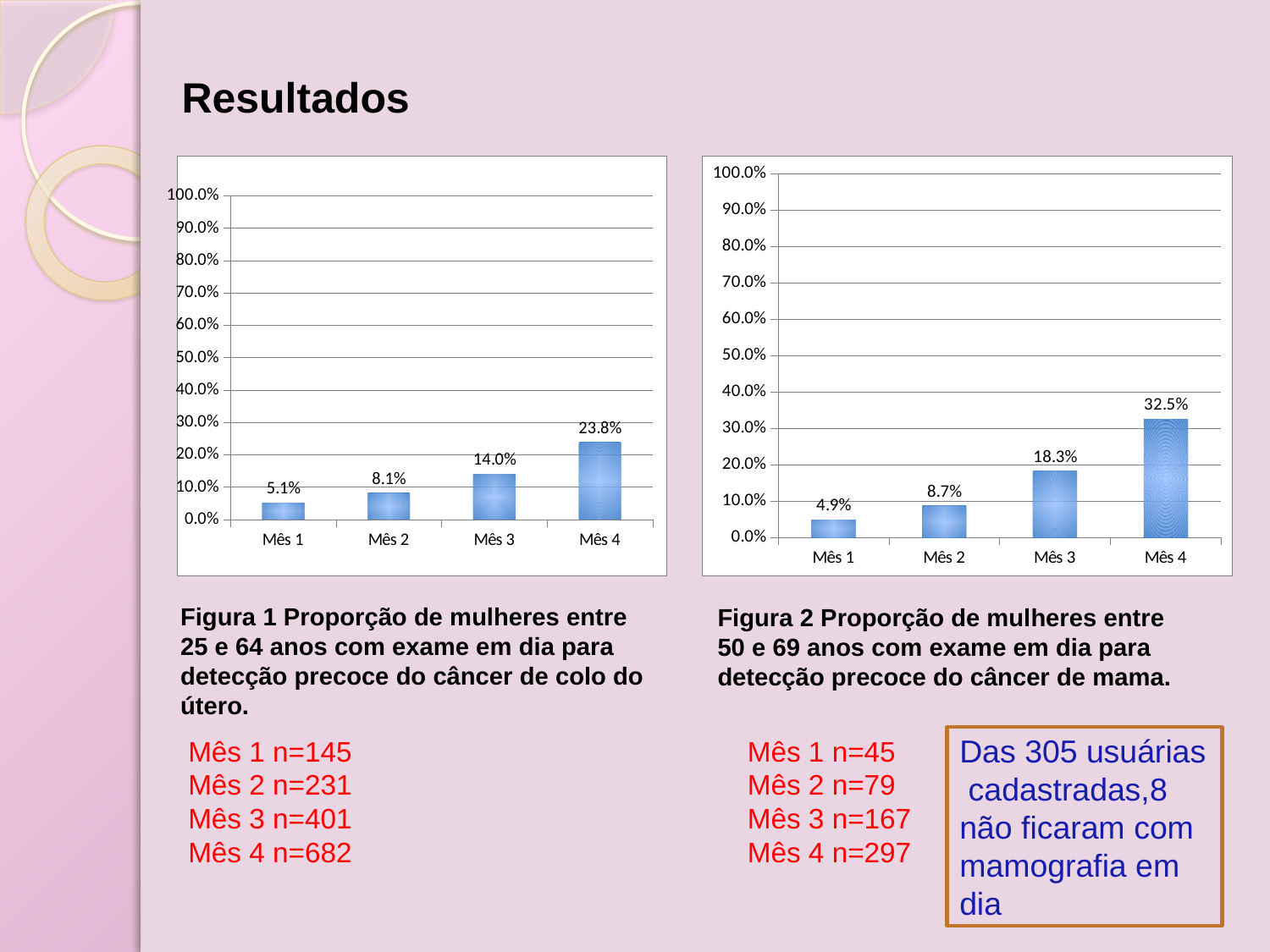
How many months are shown on the x axis of the left chart (Figura 1)? 4 Which is larger: the value for Mês 2 in the left chart (Figura 1) or the value for Mês 2 in the right chart (Figura 2)? Mês 2 in the right chart (Figura 2) In the right chart (Figura 2), is the value for Mês 4 greater or less than 30.0%? greater In the right chart (Figura 2), what is the difference between the values for Mês 3 and Mês 2? 9.6% In the left chart (Figura 1), what is the difference between the values for Mês 4 and Mês 1? 18.7% In the left chart (Figura 1), which month has the highest value? Mês 4 In the left chart (Figura 1), what is the value for Mês 3? 14.0% What is the value of the top tick on the y axis of the right chart (Figura 2)? 100.0% What type of chart is the right chart (Figura 2)? Bar chart In the right chart (Figura 2), which month has the lowest value? Mês 1 In the right chart (Figura 2), what is the value for Mês 4? 32.5% In the left chart (Figura 1), do the values rise or fall from Mês 1 to Mês 4? Rise